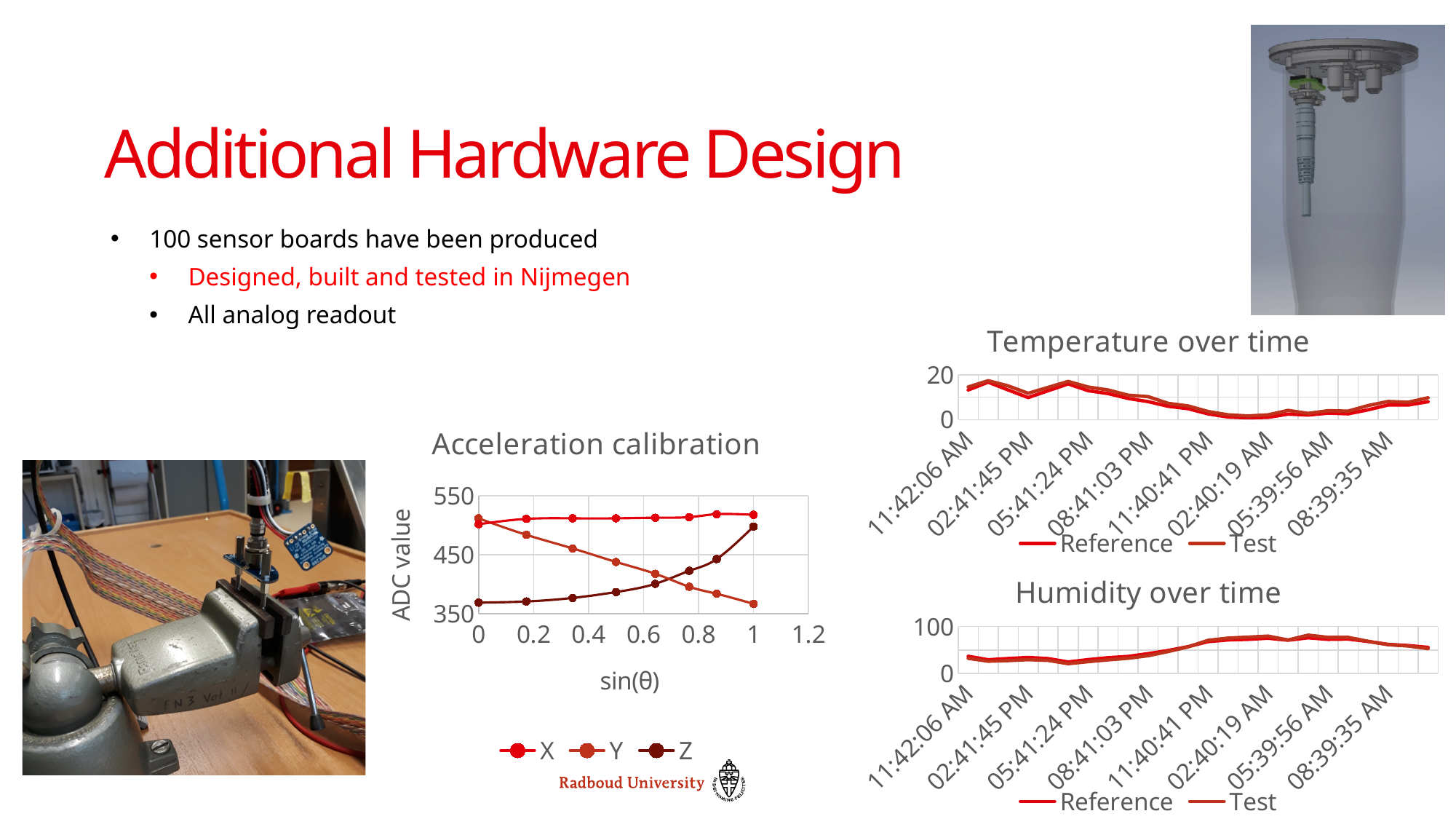
In the "Acceleration calibration" chart, is the Y value at sin(θ) = 0 greater or less than 450? greater In the "Acceleration calibration" chart, does the Z series rise or fall as sin(θ) increases? rise How many series does the legend of the "Acceleration calibration" chart list? 3 In the "Humidity over time" chart, is the Reference value at 05:39:56 AM greater or less than 50? greater What are the legend entries of the "Humidity over time" chart? Reference, Test In the "Temperature over time" chart, is the Reference value at 02:40:19 AM greater or less than 20? less What kind of chart is the "Acceleration calibration" chart? line chart How many series does the legend of the "Temperature over time" chart list? 2 In the "Acceleration calibration" chart, which series is higher at sin(θ) = 1: Y or Z? Z What is the y-axis label of the "Acceleration calibration" chart? ADC value In the "Acceleration calibration" chart, does the Y series rise or fall as sin(θ) increases? fall